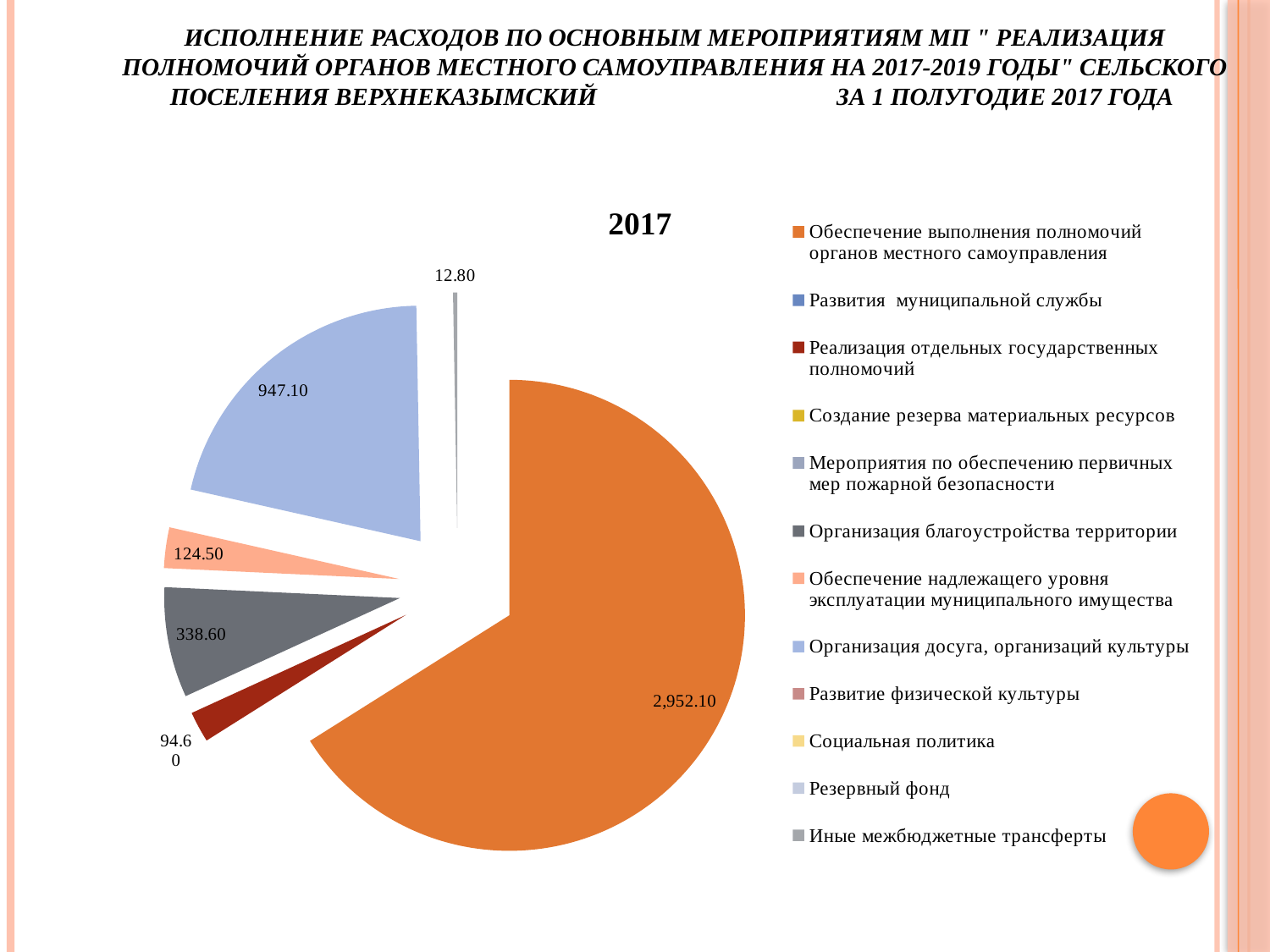
Which is larger: the value for Организация благоустройства территории or the value for Реализация отдельных государственных полномочий? Организация благоустройства территории What is the value for Обеспечение выполнения полномочий органов местного самоуправления? 2,952.10 What is the difference between the values for Обеспечение выполнения полномочий органов местного самоуправления and Организация досуга, организаций культуры? 2,005.00 Which labelled slice has the smallest value? Иные межбюджетные трансферты What is the title of the chart? 2017 What is the value for Организация благоустройства территории? 338.60 Which category has the largest slice of the pie? Обеспечение выполнения полномочий органов местного самоуправления What kind of chart is shown on the slide? Pie chart What is the value for Обеспечение надлежащего уровня эксплуатации муниципального имущества? 124.50 What is the value for Иные межбюджетные трансферты? 12.80 How many entries does the chart legend list? 12 What is the value for Организация досуга, организаций культуры? 947.10